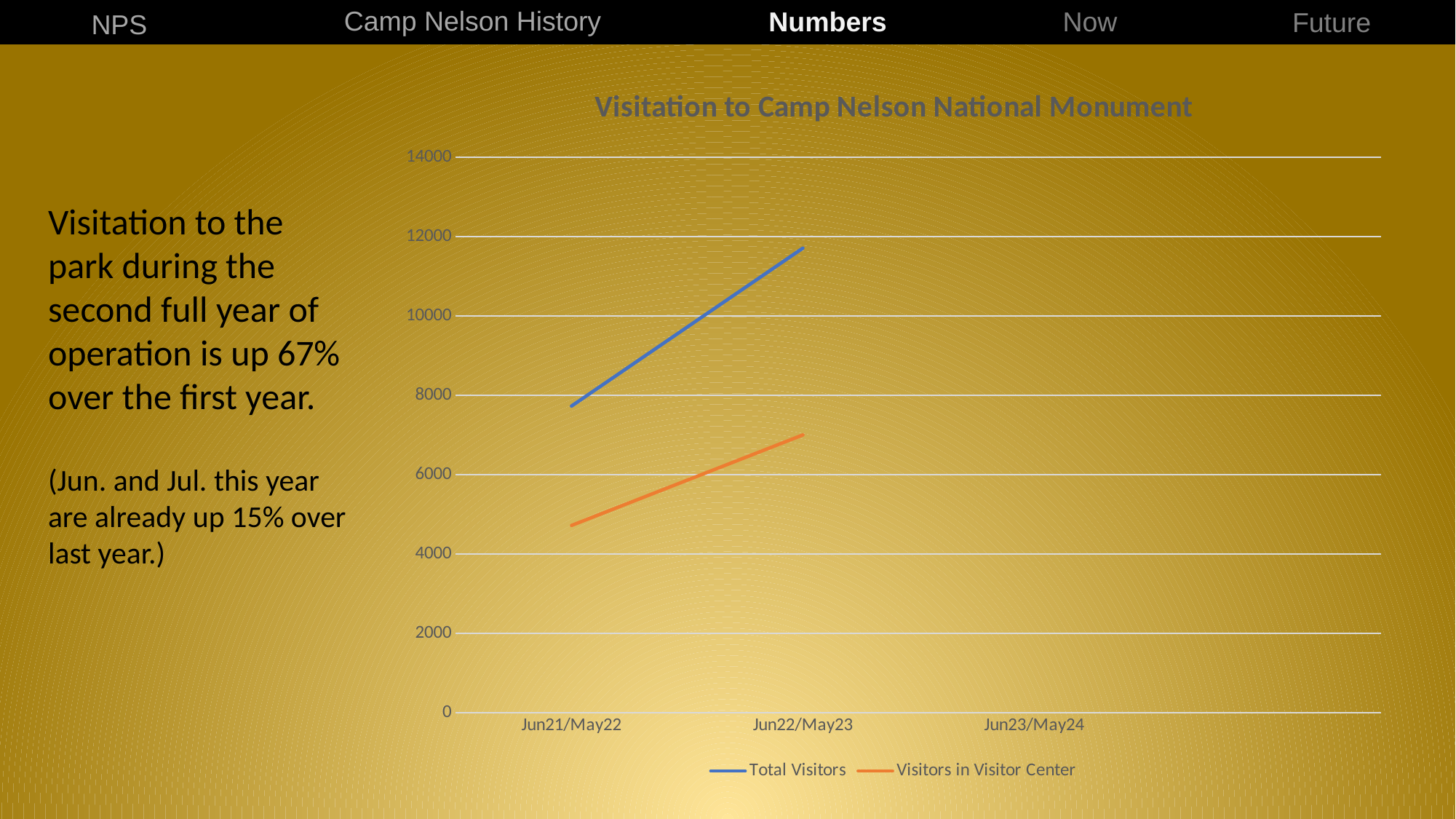
Does the Total Visitors line rise or fall from Jun21/May22 to Jun22/May23? rise Does the Visitors in Visitor Center line rise or fall from Jun21/May22 to Jun22/May23? rise Is the Total Visitors value for Jun21/May22 greater or less than 6000? greater Is the Visitors in Visitor Center value for Jun21/May22 greater or less than 4000? greater What is the title of the chart? Visitation to Camp Nelson National Monument What kind of chart is shown on the slide? line chart Is the Visitors in Visitor Center value for Jun22/May23 greater or less than 8000? less How many series does the chart's legend list? 2 At Jun22/May23, which is larger: Total Visitors or Visitors in Visitor Center? Total Visitors How many periods are labelled on the x axis of the chart? 3 Which series is drawn in orange in the chart? Visitors in Visitor Center